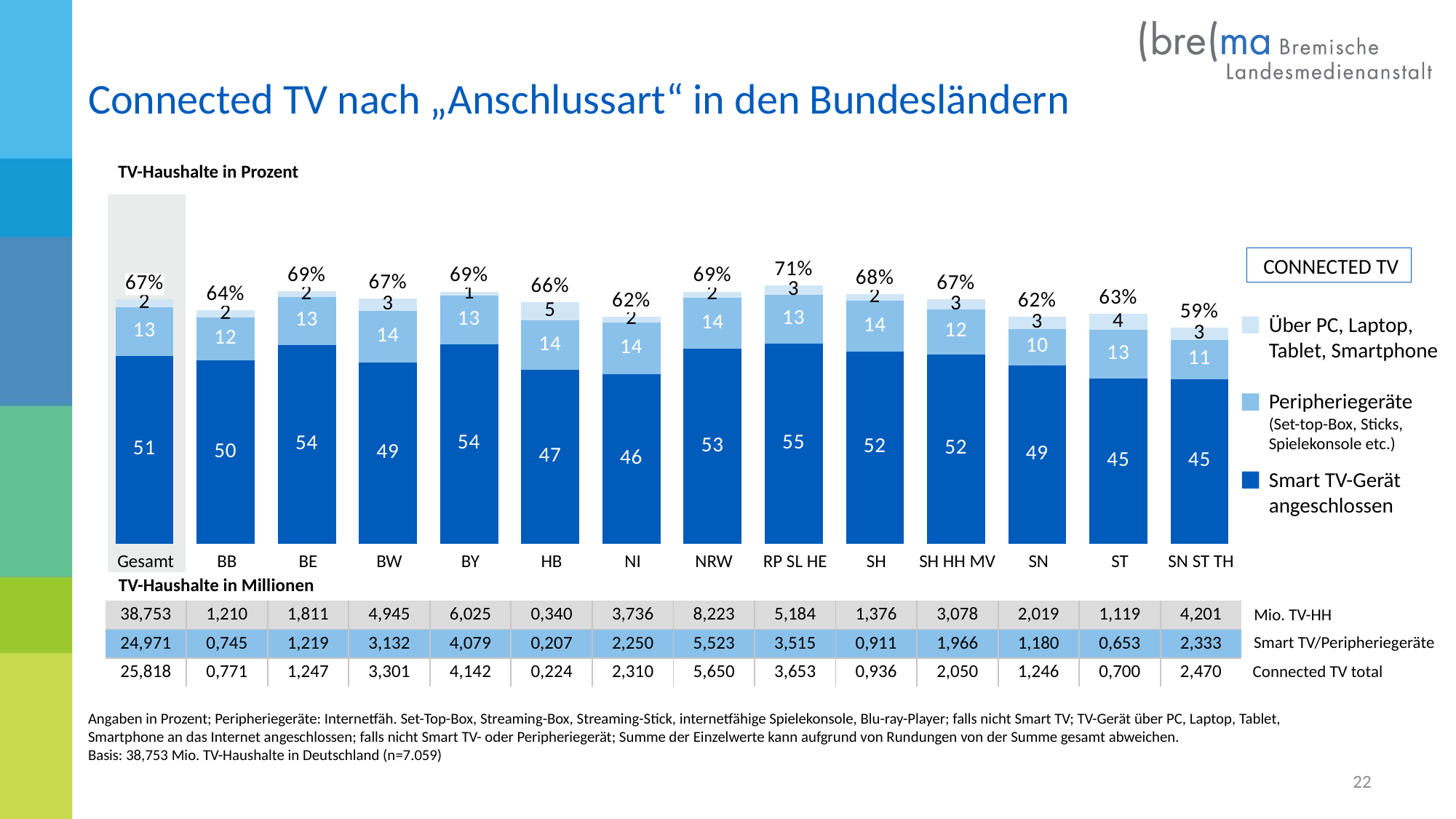
Which category has the highest Connected TV total percentage? RP SL HE What is the Über PC, Laptop, Tablet, Smartphone value for HB? 5 What is the difference between the Smart TV-Gerät angeschlossen values for BE and ST? 9 What type of chart is shown on the slide? stacked bar chart Which category has the lowest Connected TV total percentage? SN ST TH Which has a larger Smart TV-Gerät angeschlossen value, BY or NI? BY How many categories (bars) are shown in the chart? 14 What is the Connected TV total percentage shown above the bar for RP SL HE? 71% What is the Connected TV total percentage for Gesamt? 67% What is the Smart TV-Gerät angeschlossen value for NRW? 53 What is the Peripheriegeräte value for HB? 14 How many series does the legend list? 3